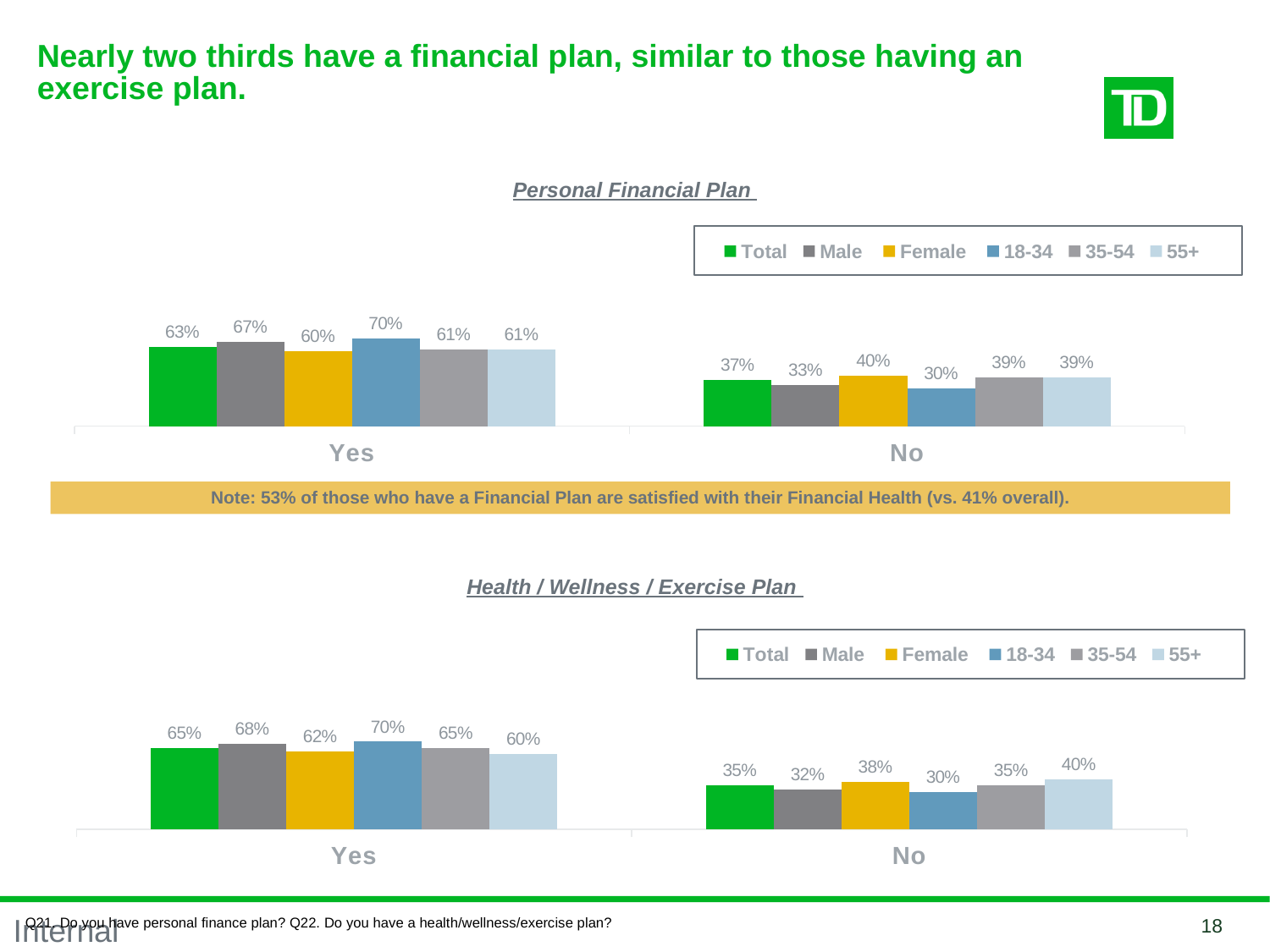
In the Health / Wellness / Exercise Plan chart, which series has the lowest value in the No category? 18-34 What kind of chart is the Personal Financial Plan chart? Bar chart In the Personal Financial Plan chart, what is the value for 18-34 in the No category? 30% In the Health / Wellness / Exercise Plan chart, what is the value for Female in the Yes category? 62% In the Personal Financial Plan chart, what is the difference between the Male and Female values in the Yes category? 7% In the Health / Wellness / Exercise Plan chart, what is the difference between the Total values for Yes and No? 30% In the Personal Financial Plan chart, what is the value for Total in the Yes category? 63% In the Health / Wellness / Exercise Plan chart, which is larger in the Yes category: Male or 55+? Male How many categories are shown on the x axis of the Health / Wellness / Exercise Plan chart? 2 In the Health / Wellness / Exercise Plan chart, what is the value for 55+ in the No category? 40% In the Personal Financial Plan chart, which series has the highest value in the Yes category? 18-34 In the Personal Financial Plan chart, how many series does the legend list? 6